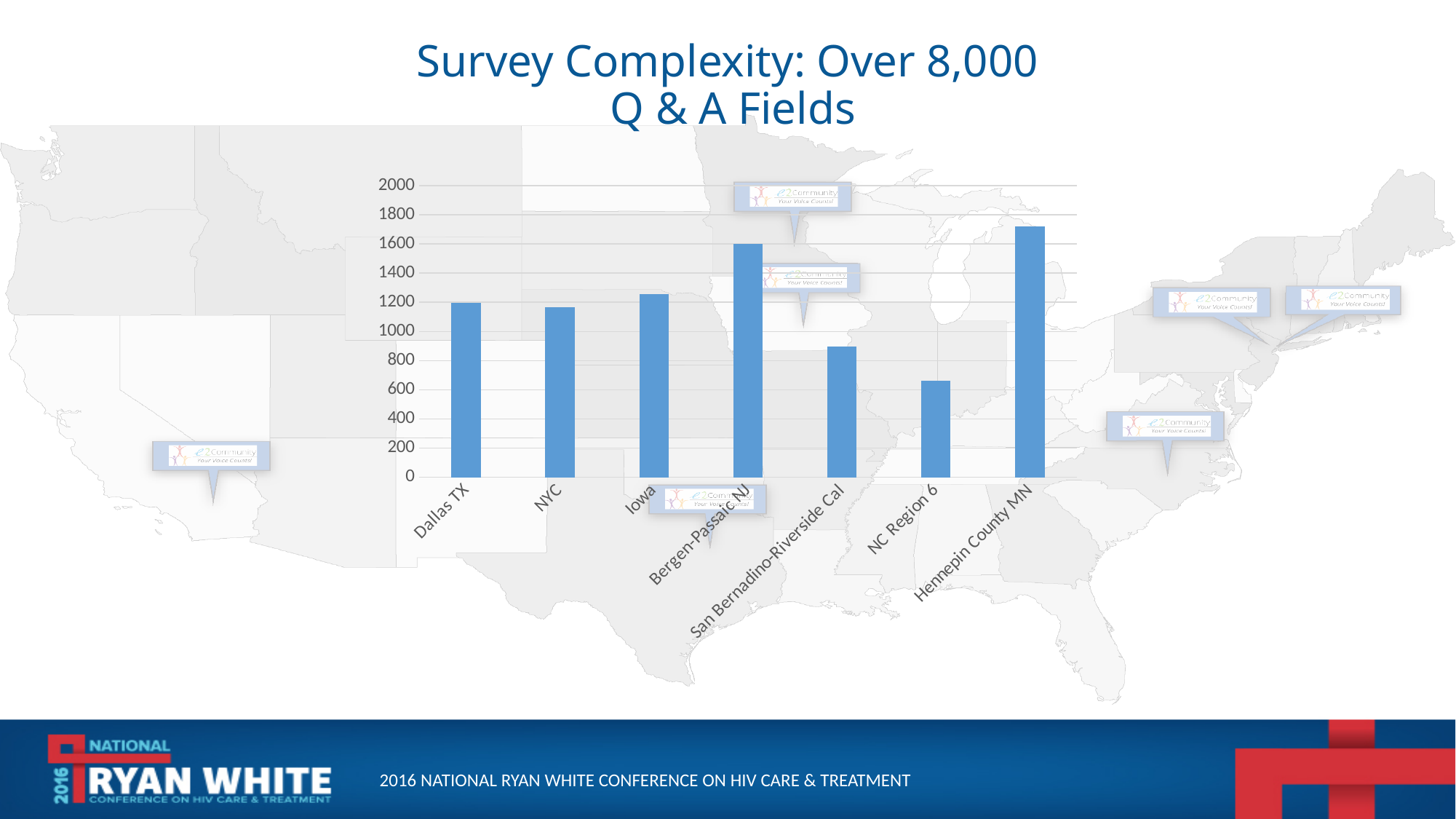
Which is larger, the value for Bergen-Passaic NJ or the value for Hennepin County MN? Hennepin County MN Is the value for Bergen-Passaic NJ greater or less than 1400? greater What is the title of the slide containing the chart? Survey Complexity: Over 8,000 Q & A Fields Is the value for Hennepin County MN greater or less than 1600? greater Which location has the highest bar on the chart? Hennepin County MN Which is larger, the value for San Bernadino-Riverside Cal or the value for NC Region 6? San Bernadino-Riverside Cal Which location has the lowest bar on the chart? NC Region 6 Is the value for San Bernadino-Riverside Cal greater or less than 1000? less How many categories (locations) are plotted on the chart? 7 What kind of chart is shown on the slide? bar chart